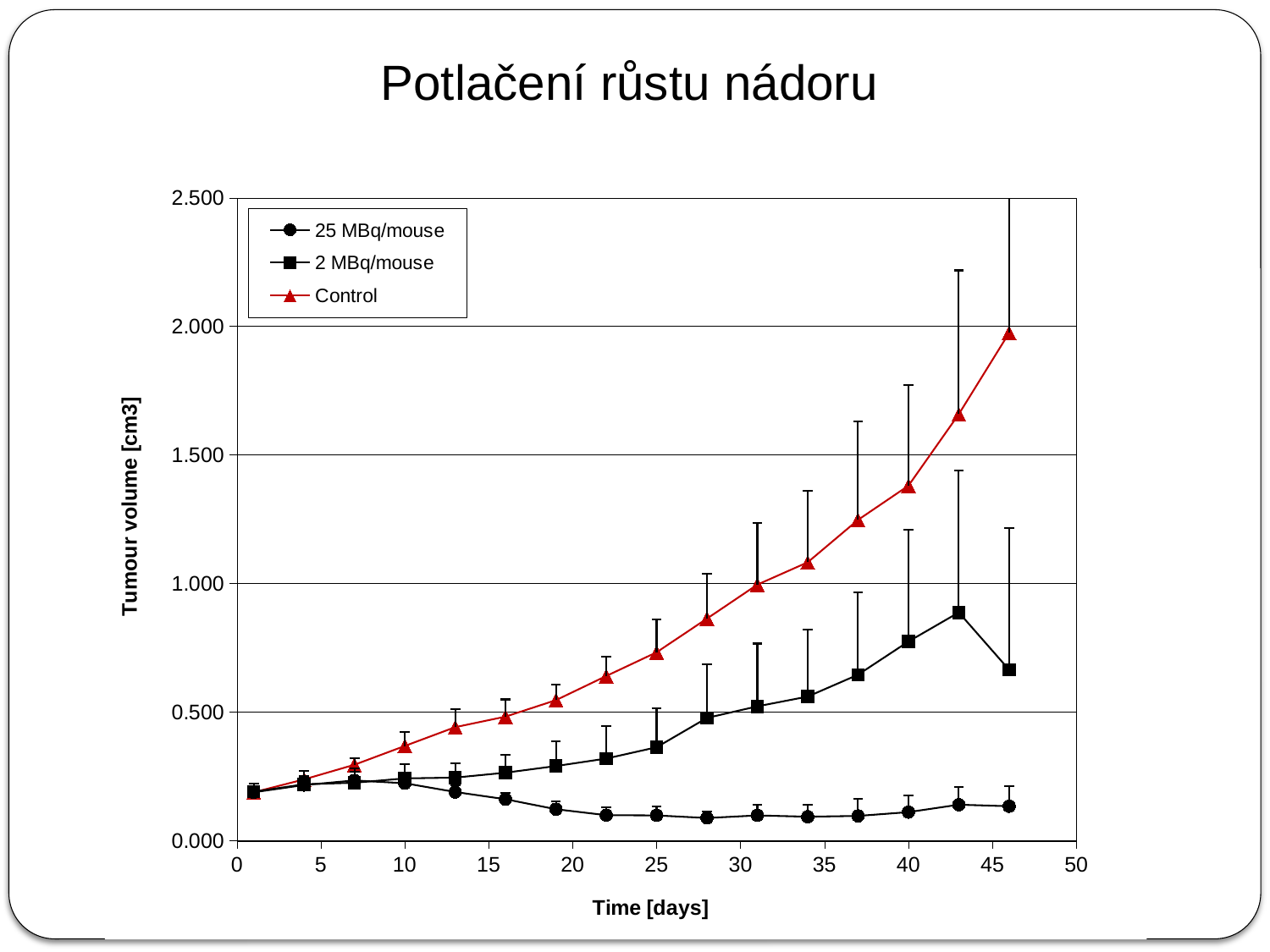
At day 28, which series has the larger tumour volume, 2 MBq/mouse or 25 MBq/mouse? 2 MBq/mouse Is the 25 MBq/mouse value at day 46 greater or less than 0.500? less Is the Control value at day 43 greater or less than 1.500? greater What kind of chart is shown on the slide? line chart What is the title of the chart's y axis? Tumour volume [cm3] Which series has the highest tumour volume at day 46? Control Is the Control value at day 40 greater or less than 1.500? less How many series does the legend list? 3 Which series is drawn in red with triangle markers? Control Which series has the lowest tumour volume at day 46? 25 MBq/mouse Does the Control series rise or fall as time increases? rise